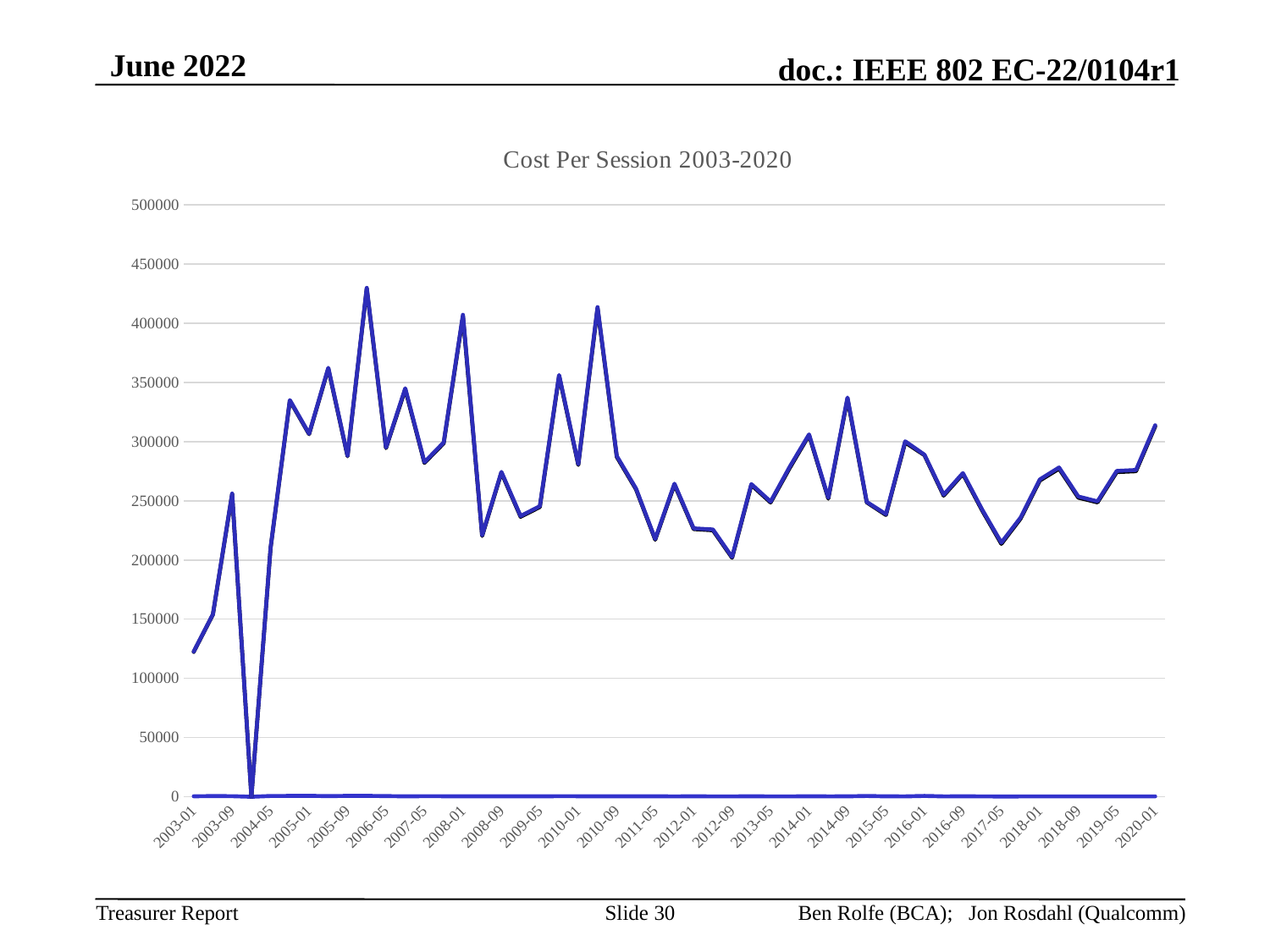
What kind of chart is shown on the slide? line chart What is the highest value shown on the vertical axis? 500000 Is the value for 2017-05 greater or less than 250000? less Is the value for 2020-01 greater or less than 250000? greater Is the value for 2003-01 greater or less than 150000? less What is the title of the chart? Cost Per Session 2003-2020 Between 2003-01 and 2003-09, does the line rise or fall? rise Which is larger, the value for 2003-01 or the value for 2004-05? 2004-05 Which is larger, the value for 2017-05 or the value for 2020-01? 2020-01 Between 2018-01 and 2018-09, does the line rise or fall? fall